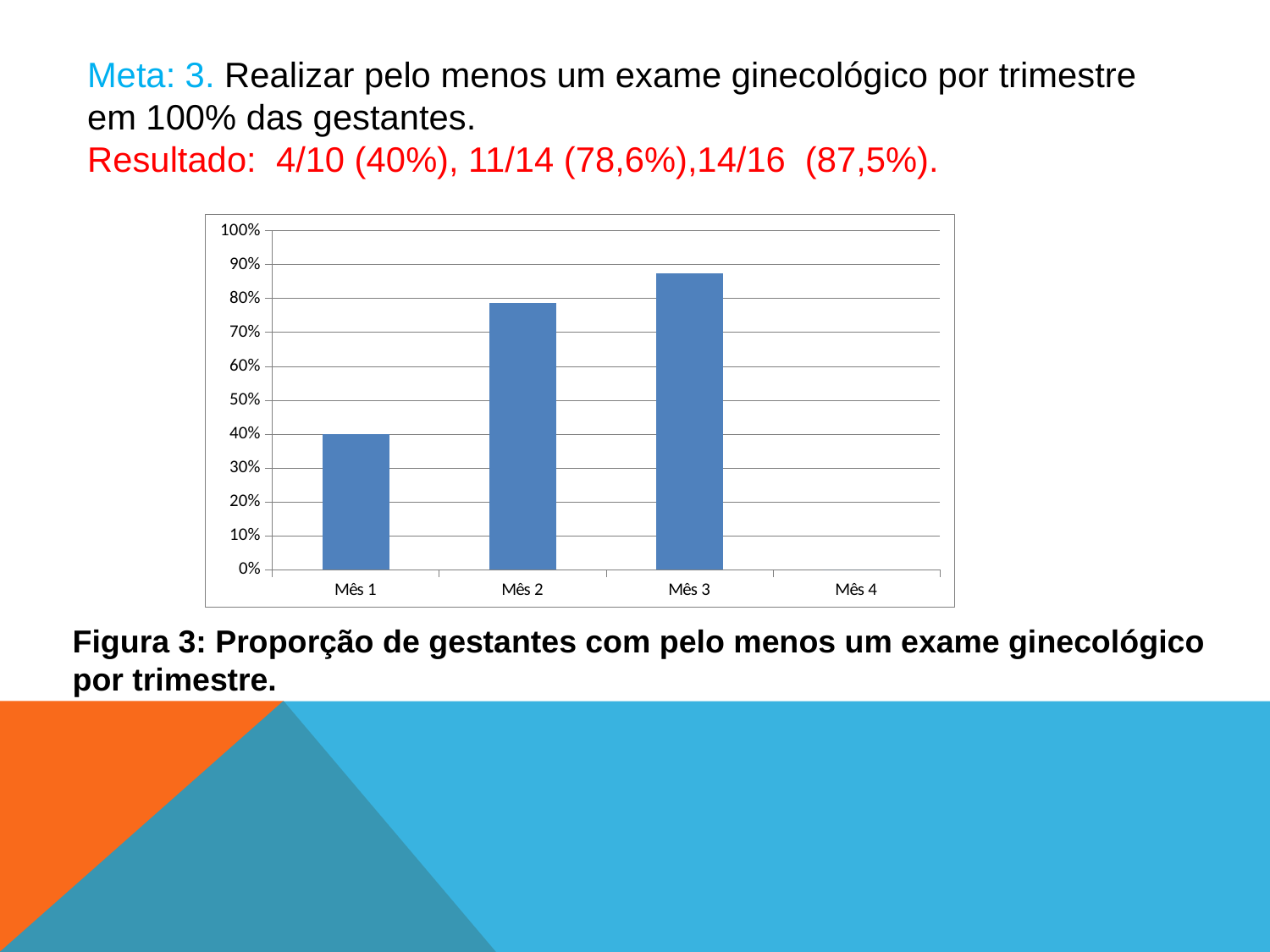
How many categories are labelled on the x axis? 4 Which month with a bar has the lowest value? Mês 1 Is the value for Mês 2 greater or less than 80%? less Which month has the highest bar? Mês 3 Is the value for Mês 2 greater or less than 70%? greater How many bars are plotted in the chart? 3 Do the values rise or fall from Mês 1 to Mês 3? rise What is the figure caption below the chart? Figura 3: Proporção de gestantes com pelo menos um exame ginecológico por trimestre. What kind of chart is shown on the slide? bar chart Is the value for Mês 3 greater or less than 90%? less What is the value for Mês 1? 40% Which is larger, the value for Mês 2 or the value for Mês 3? Mês 3